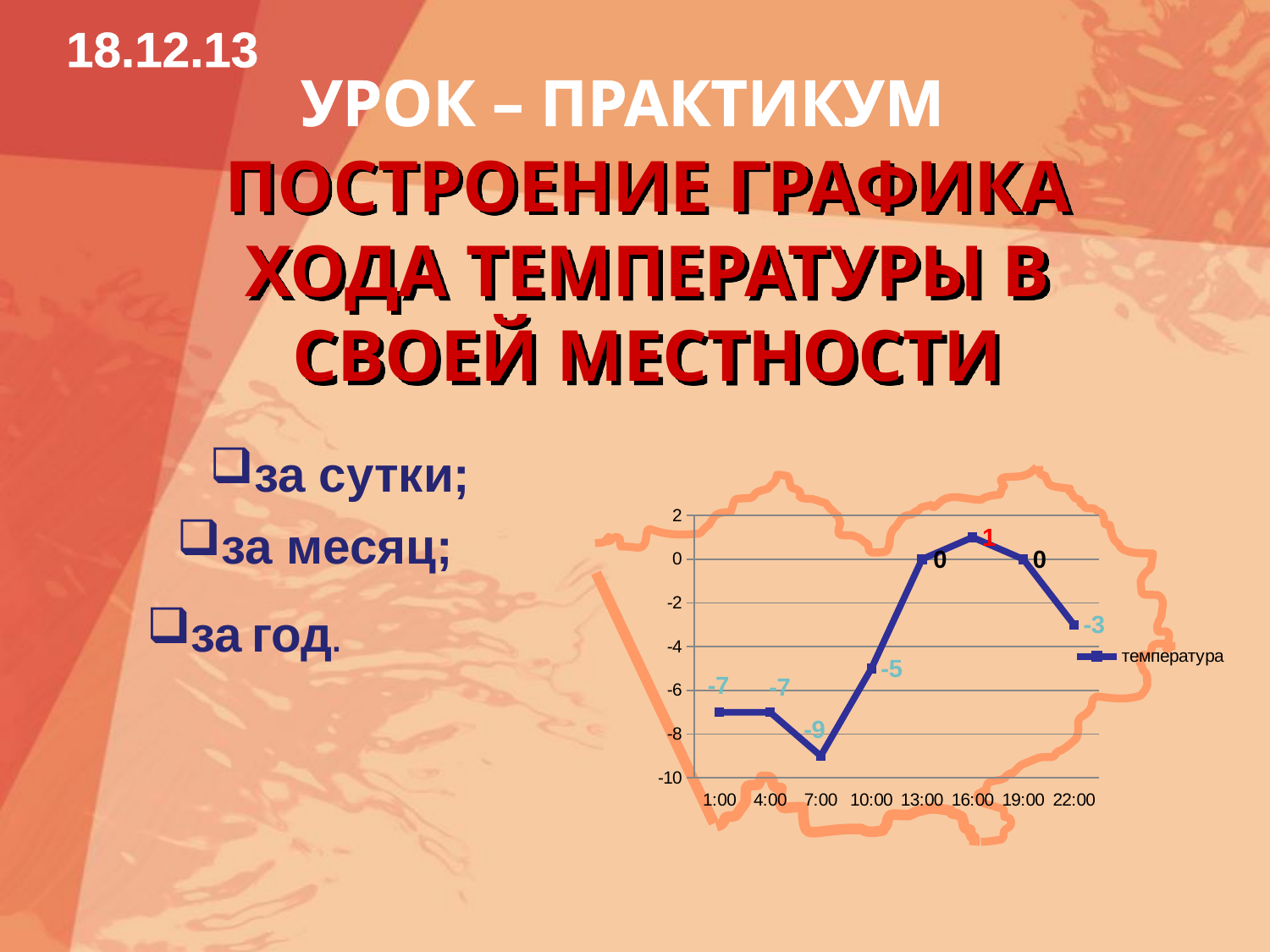
At which time is the temperature highest? 16:00 What is the difference between the temperature at 16:00 and at 7:00? 10 What is the temperature value at 16:00? 1 Which is larger, the temperature at 10:00 or at 22:00? 22:00 What is the name of the series shown in the legend? температура How many series does the legend list? 1 What kind of chart is shown on the slide? line chart What is the temperature value at 7:00? -9 What is the temperature value at 22:00? -3 At which time is the temperature lowest? 7:00 What is the temperature value at 10:00? -5 How many time points are plotted on the chart? 8